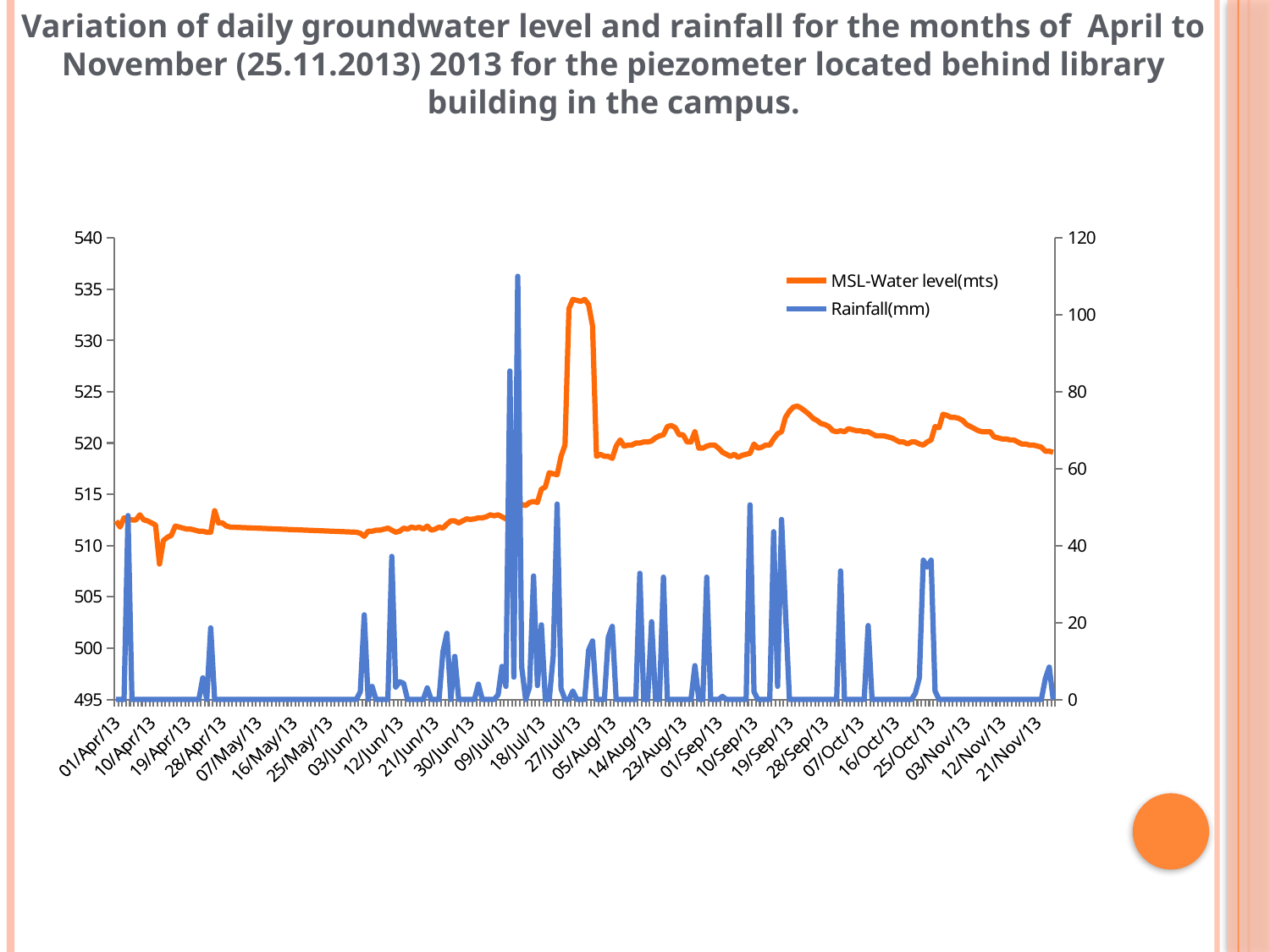
Is the MSL-Water level(mts) value at 21/Nov/13 greater or less than 515? greater Is the Rainfall(mm) value at 16/May/13 greater or less than 20? less How many series does the legend list? 2 What kind of chart is shown on the slide? line chart Is the MSL-Water level(mts) at the end of the period (November) higher or lower than at the start (April)? higher Is the MSL-Water level(mts) value at 01/Apr/13 greater or less than 515? less Between 09/Jul/13 and 27/Jul/13, does the MSL-Water level(mts) line rise or fall? rise What are the two series named in the legend? MSL-Water level(mts) and Rainfall(mm) Which colour is used for the Rainfall(mm) series? blue